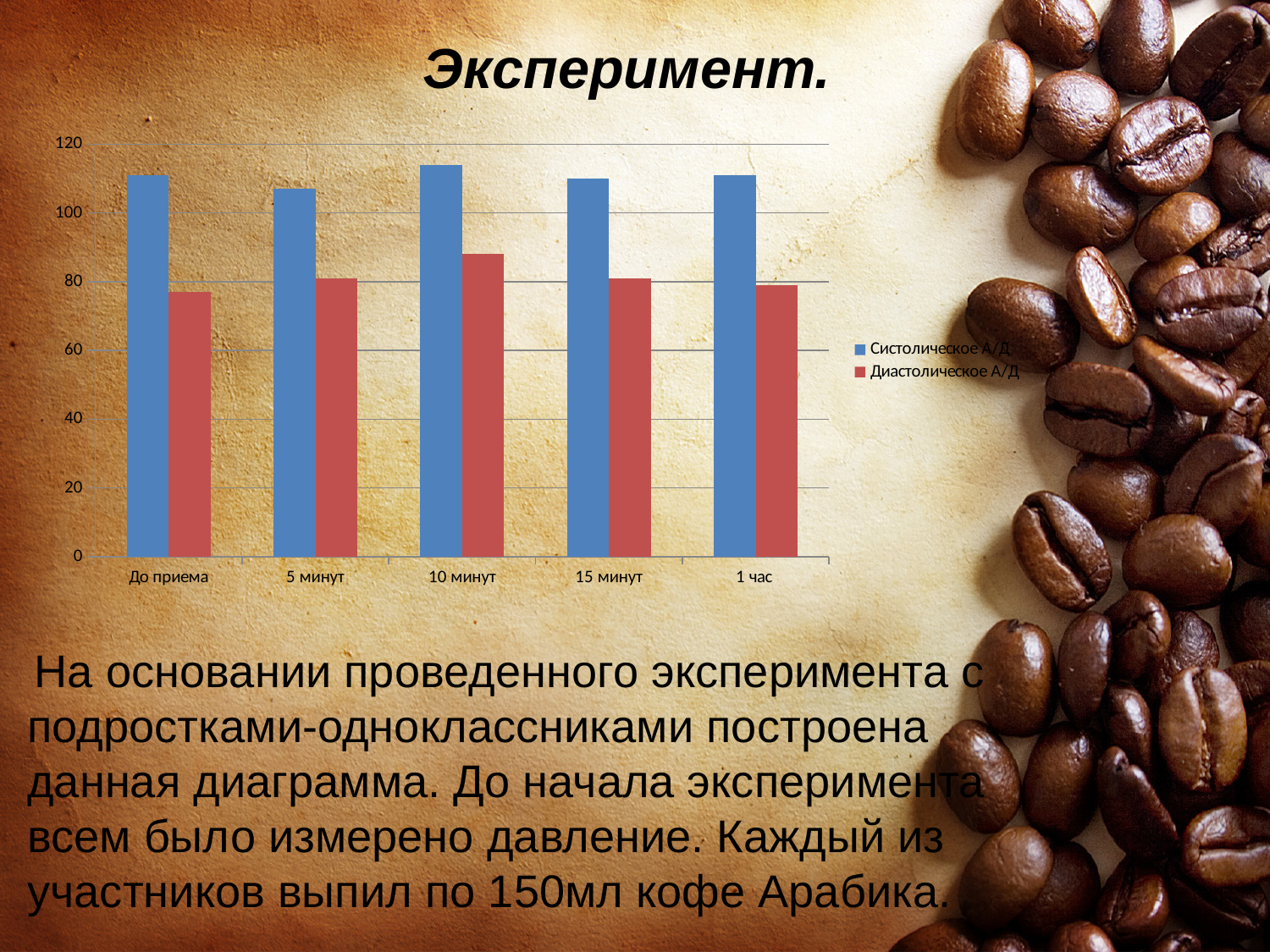
At which time point is the Диастолическое А/Д value highest? 10 минут Is the Систолическое А/Д value at 5 минут greater or less than 100? greater Which is larger: the Диастолическое А/Д value at 10 минут or at 5 минут? 10 минут At which time point is the Систолическое А/Д value lowest? 5 минут How many categories are shown on the x axis of the chart? 5 At which time point is the Систолическое А/Д value highest? 10 минут Is the Диастолическое А/Д value at 10 минут greater or less than 80? greater Which colour represents Диастолическое А/Д in the chart? red Is the Диастолическое А/Д value at До приема greater or less than 80? less What are the two series named in the chart legend? Систолическое А/Д and Диастолическое А/Д What kind of chart is shown on the slide? bar chart How many series does the chart legend list? 2